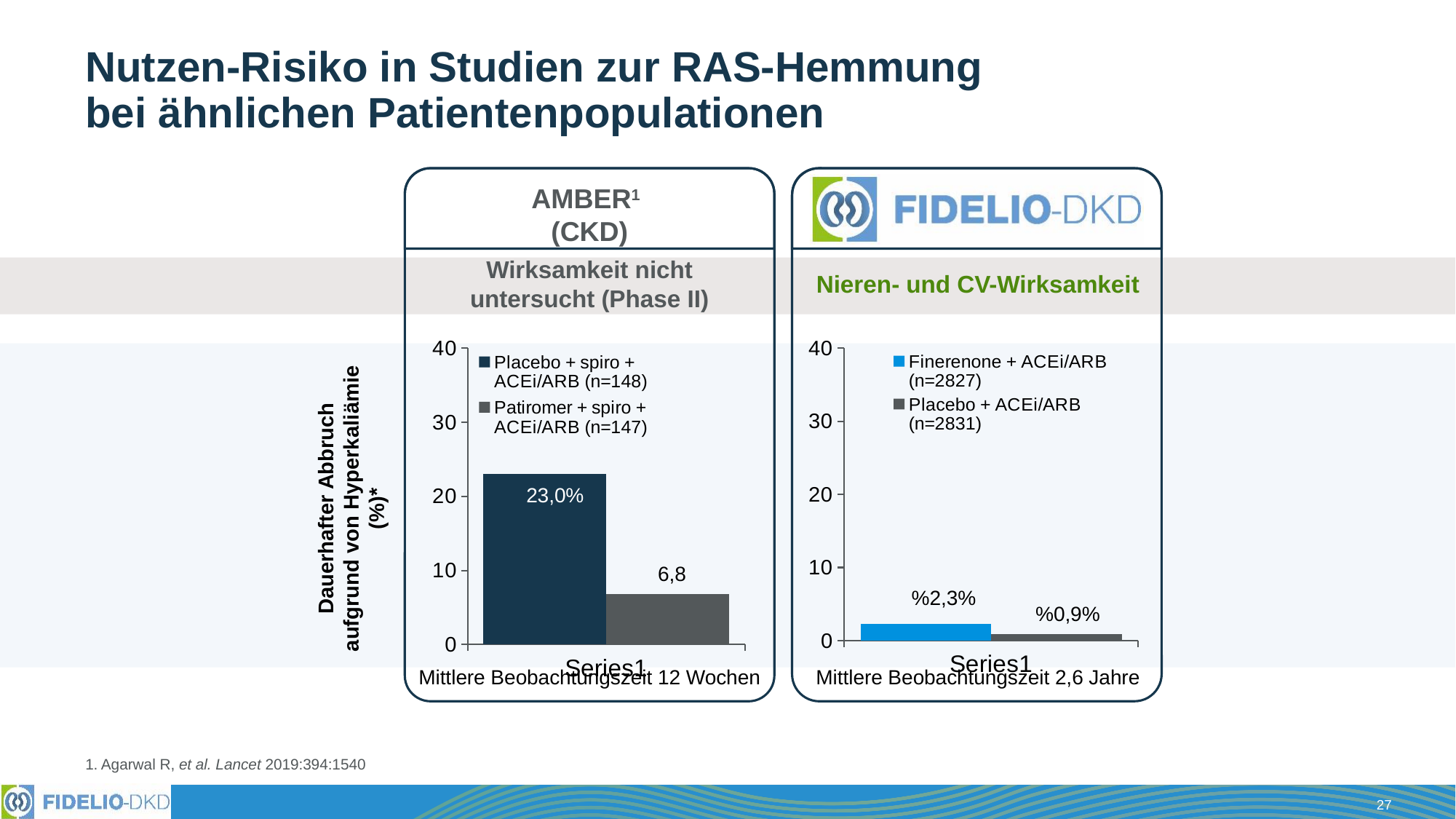
In the AMBER (CKD) chart on the left, what is the data label on the bar for Placebo + spiro + ACEi/ARB (n=148)? 23,0% In the AMBER (CKD) chart on the left, is the bar for Placebo + spiro + ACEi/ARB greater or less than 20? greater What kind of chart is the FIDELIO-DKD chart on the right? Bar chart In the AMBER (CKD) chart on the left, which series has the higher bar? Placebo + spiro + ACEi/ARB (n=148) In the FIDELIO-DKD chart on the right, which series has the lower bar? Placebo + ACEi/ARB (n=2831) How many series does the legend of the AMBER (CKD) chart on the left list? 2 In the AMBER (CKD) chart on the left, what is the data label on the bar for Patiromer + spiro + ACEi/ARB (n=147)? 6,8 In the FIDELIO-DKD chart on the right, what is the data label on the bar for Placebo + ACEi/ARB (n=2831)? %0,9% How many series does the legend of the FIDELIO-DKD chart on the right list? 2 What is the maximum value shown on the y axis of the AMBER (CKD) chart on the left? 40 In the FIDELIO-DKD chart on the right, is the bar for Finerenone + ACEi/ARB greater or less than 10? less In the FIDELIO-DKD chart on the right, what is the data label on the bar for Finerenone + ACEi/ARB (n=2827)? %2,3%